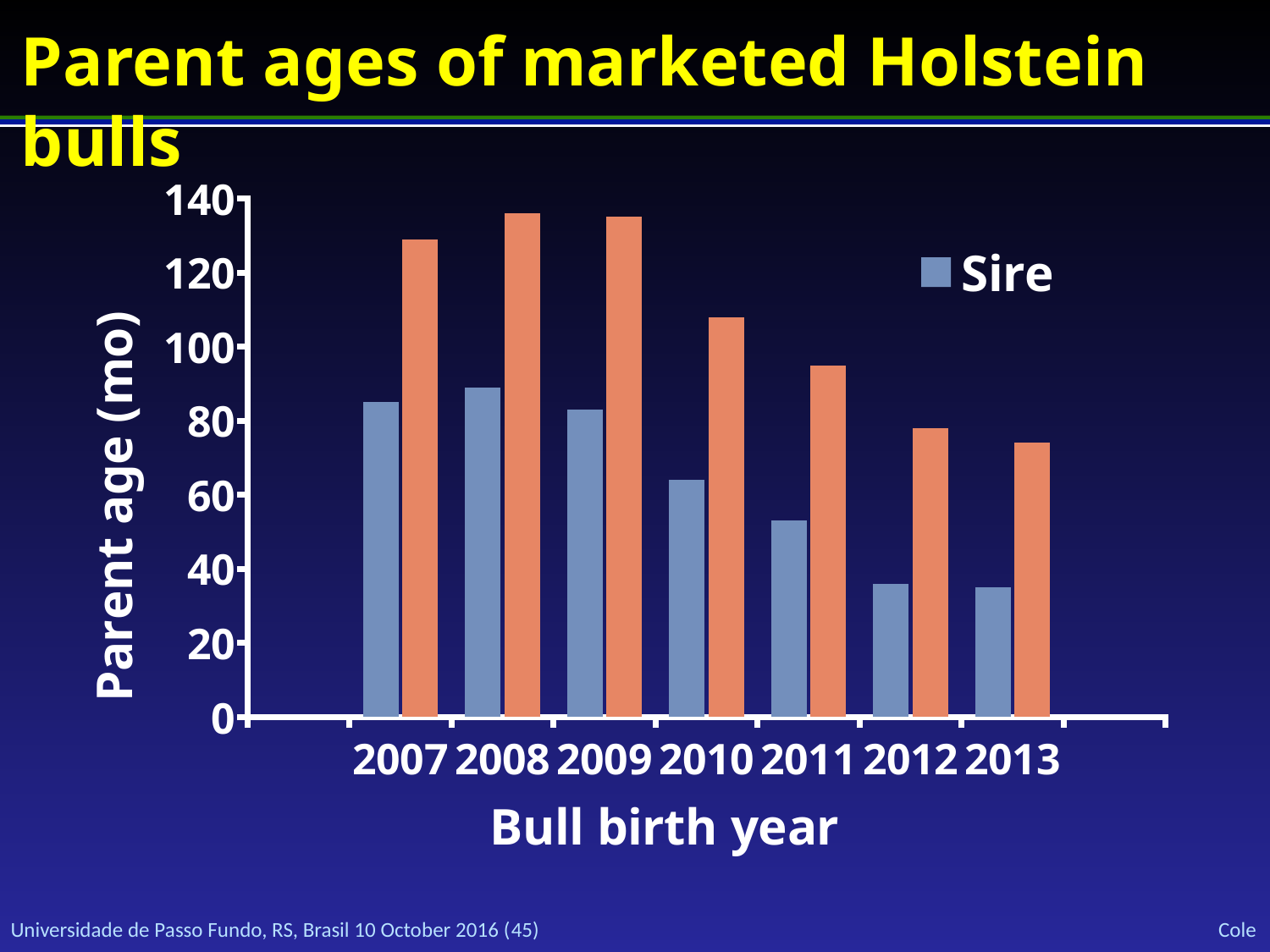
Is the orange bar for 2008 greater or less than 120? greater What kind of chart is shown on the slide? bar chart Is the Sire value for 2012 greater or less than 40? less How many bull birth years are shown on the x axis? 7 What is the title of the y axis? Parent age (mo) Is the orange bar for 2011 greater or less than 100? less Which is larger, the Sire value for 2007 or the Sire value for 2011? 2007 What is the title of the x axis? Bull birth year Do the Sire values generally rise or fall from 2007 to 2013? fall